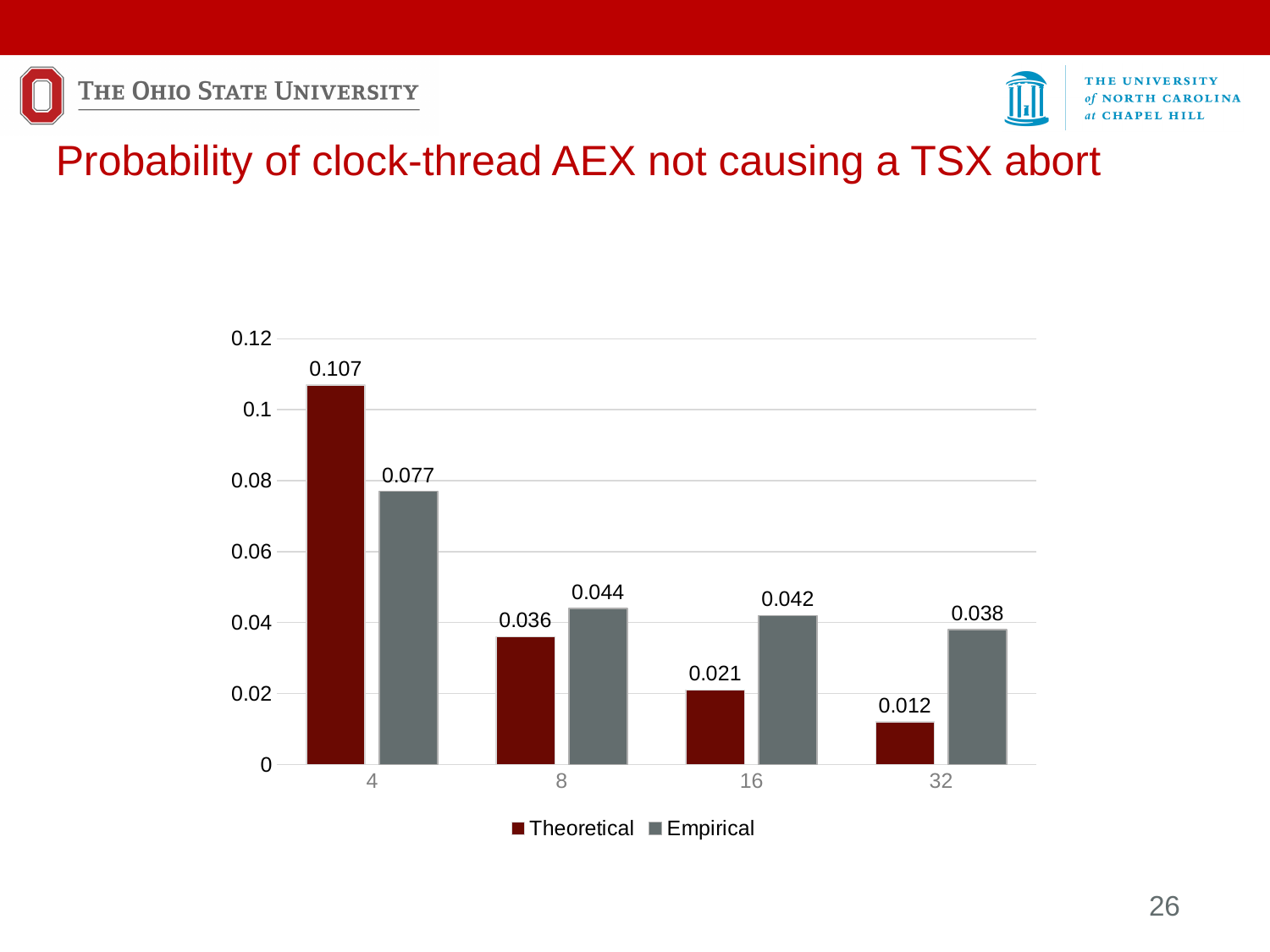
How many categories are shown on the x axis? 4 Which category has the highest Empirical value? 4 What is the difference between the Empirical values for category 8 and category 32? 0.006 What is the Theoretical value for category 32? 0.012 Which category has the lowest Theoretical value? 32 Do the Theoretical values rise or fall as the x-axis categories increase from 4 to 32? fall For category 8, which is larger, the Theoretical or the Empirical value? Empirical How many series does the legend list? 2 What is the Empirical value for category 16? 0.042 What is the Theoretical value for category 4? 0.107 What kind of chart is shown on the slide? bar chart What is the difference between the Theoretical and Empirical values for category 4? 0.03